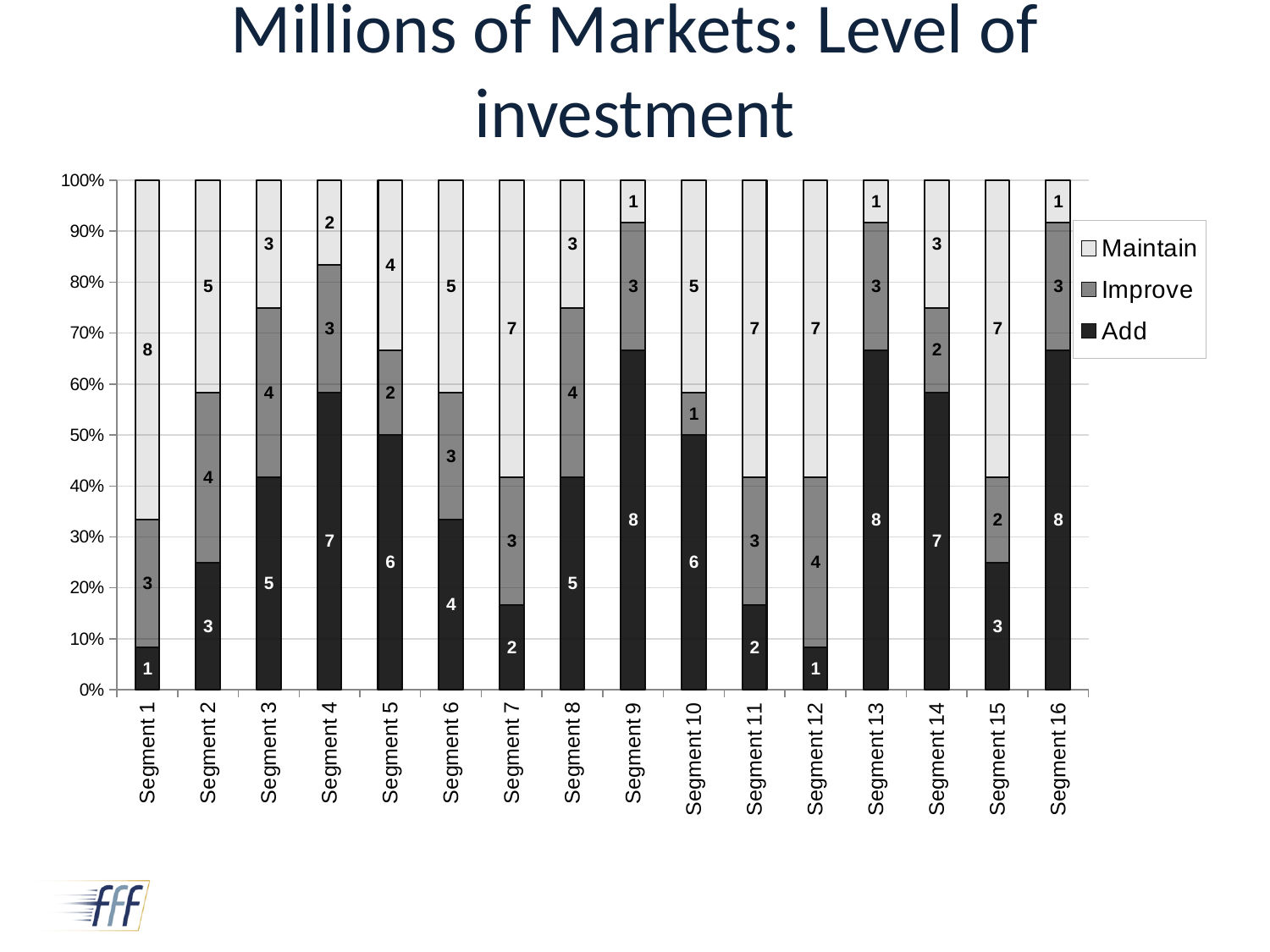
Which is larger, the Add value for Segment 4 or the Add value for Segment 7? Segment 4 What is the Improve value for Segment 10? 1 What is the Maintain value for Segment 12? 7 What is the Add value for Segment 4? 7 How many segments are shown on the x axis? 16 How many series does the legend list? 3 Which segment has the lowest Improve value? Segment 10 Which segment has the highest Maintain value? Segment 1 What is the total of the three values in the bar for Segment 6? 12 What is the difference between the Maintain and Add values for Segment 1? 7 What kind of chart is shown on the slide? Stacked bar chart Is the Add share of the bar for Segment 9 greater or less than 60%? greater